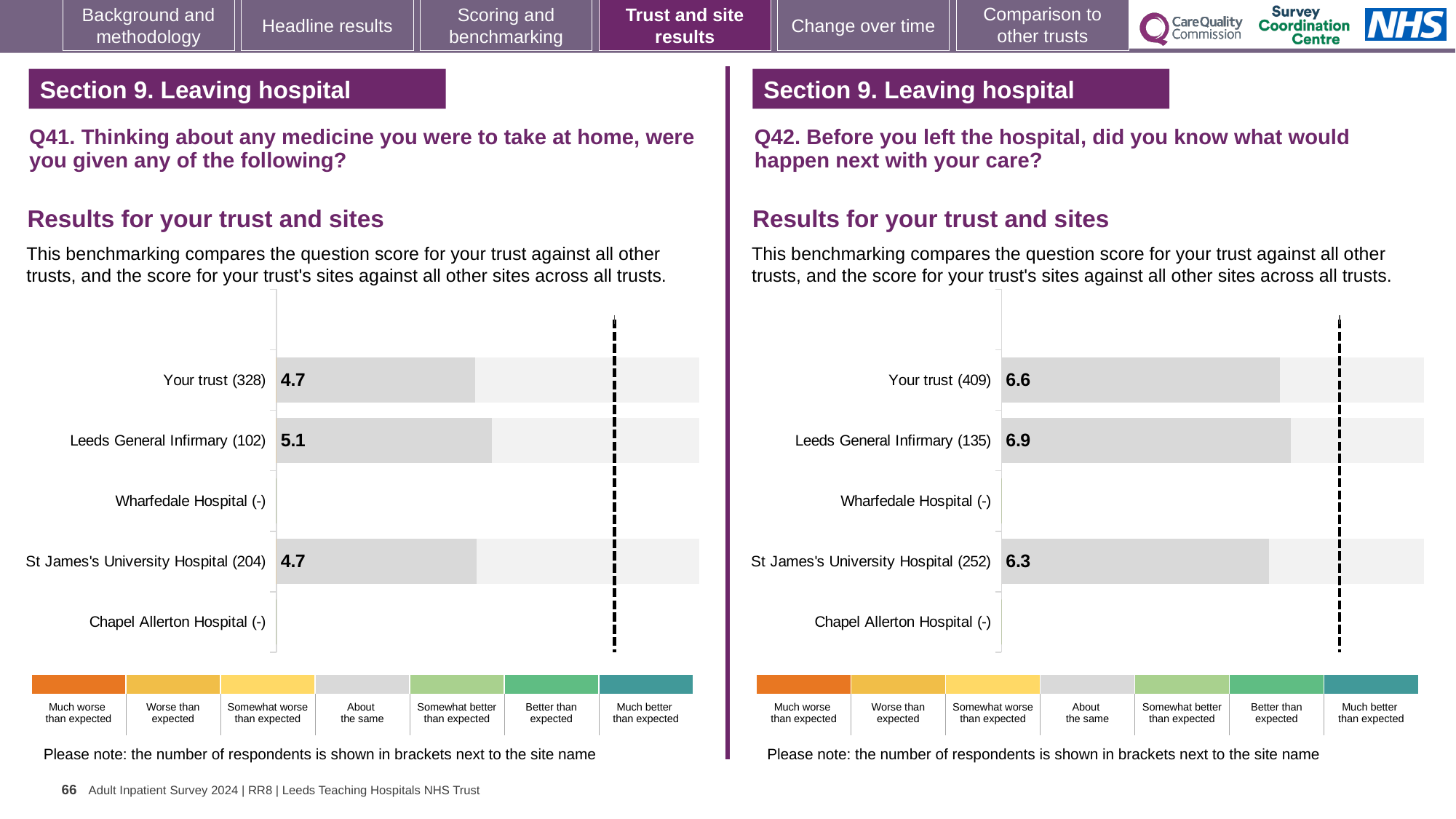
On the Q42 chart (right), what is the score for Your trust? 6.6 On the Q41 chart (left), how many respondents are shown in brackets for St James's University Hospital? 204 On the Q41 chart (left), what is the difference between the Leeds General Infirmary score and the Your trust score? 0.4 On the Q42 chart (right), what is the difference between the Leeds General Infirmary score and the St James's University Hospital score? 0.6 On the Q42 chart (right), what is the score for St James's University Hospital? 6.3 What kind of chart is used on the Q42 chart (right)? Bar chart On the Q41 chart (left), what is the score for Your trust? 4.7 On the Q42 chart (right), which site or trust row has the lowest score shown? St James's University Hospital On the Q41 chart (left), which is larger: the score for Leeds General Infirmary or the score for St James's University Hospital? Leeds General Infirmary How many site or trust rows are listed on the Q41 chart (left)? 5 On the Q42 chart (right), which site or trust row has the highest score? Leeds General Infirmary On the Q41 chart (left), what is the score for Leeds General Infirmary? 5.1